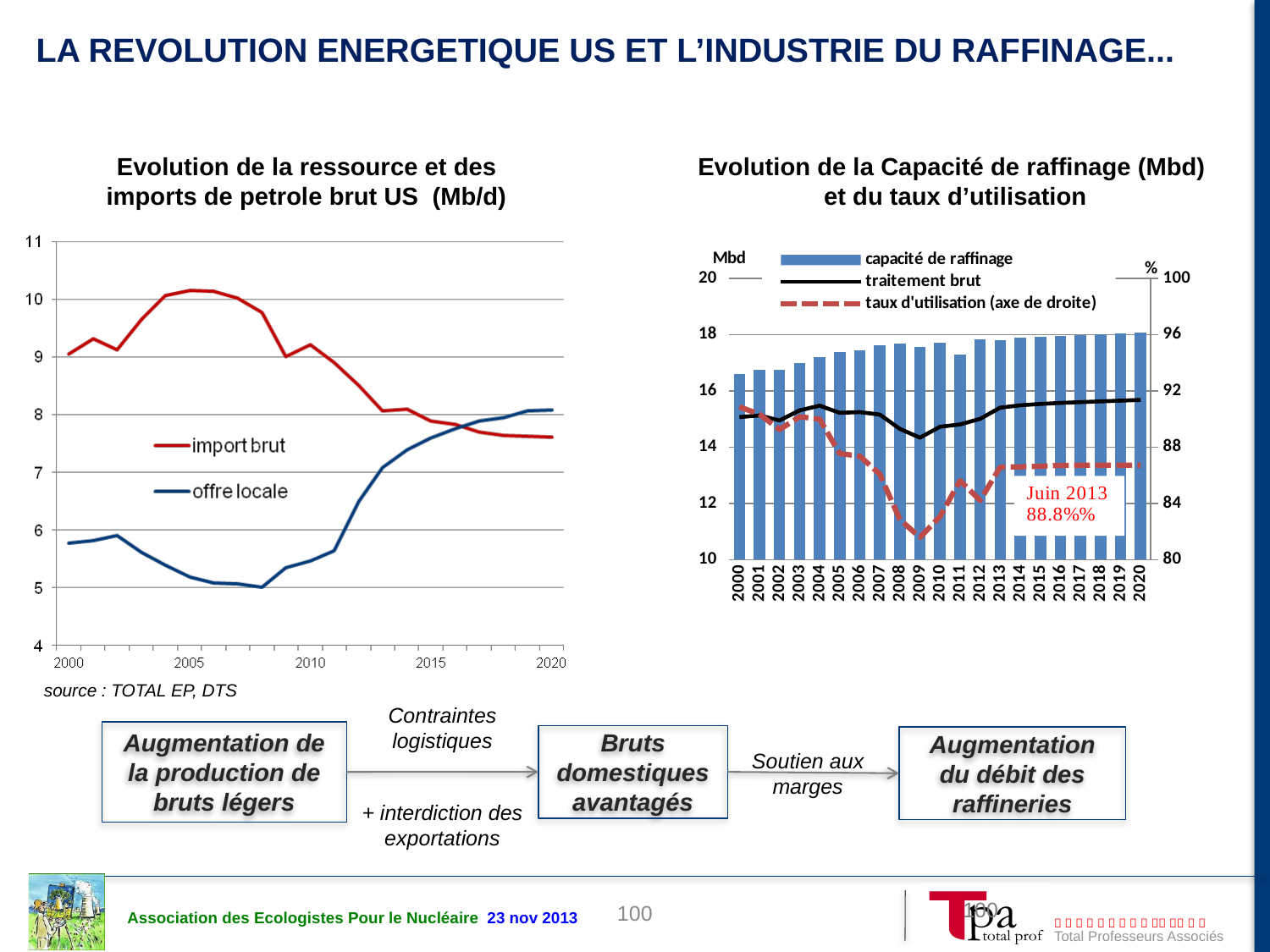
What kind of chart is the left chart, 'Evolution de la ressource et des imports de petrole brut US (Mb/d)'? line chart In the right chart, which series is plotted on the right-hand axis according to the legend? taux d'utilisation In the left chart, which series is higher in 2005, import brut or offre locale? import brut In the left chart, does import brut rise or fall between 2005 and 2020? fall In the right chart, is the taux d'utilisation in 2009 greater or less than 84? less In the left chart, which series is higher in 2020, import brut or offre locale? offre locale How many series does the legend of the left chart list? 2 In the left chart, is the value for import brut in 2005 greater or less than 9? greater In the left chart, is the value for offre locale in 2008 greater or less than 6? less How many series does the legend of the right chart, 'Evolution de la Capacité de raffinage (Mbd) et du taux d'utilisation', list? 3 How many years are shown on the x axis of the right chart? 21 In the left chart, does offre locale rise or fall between 2010 and 2020? rise